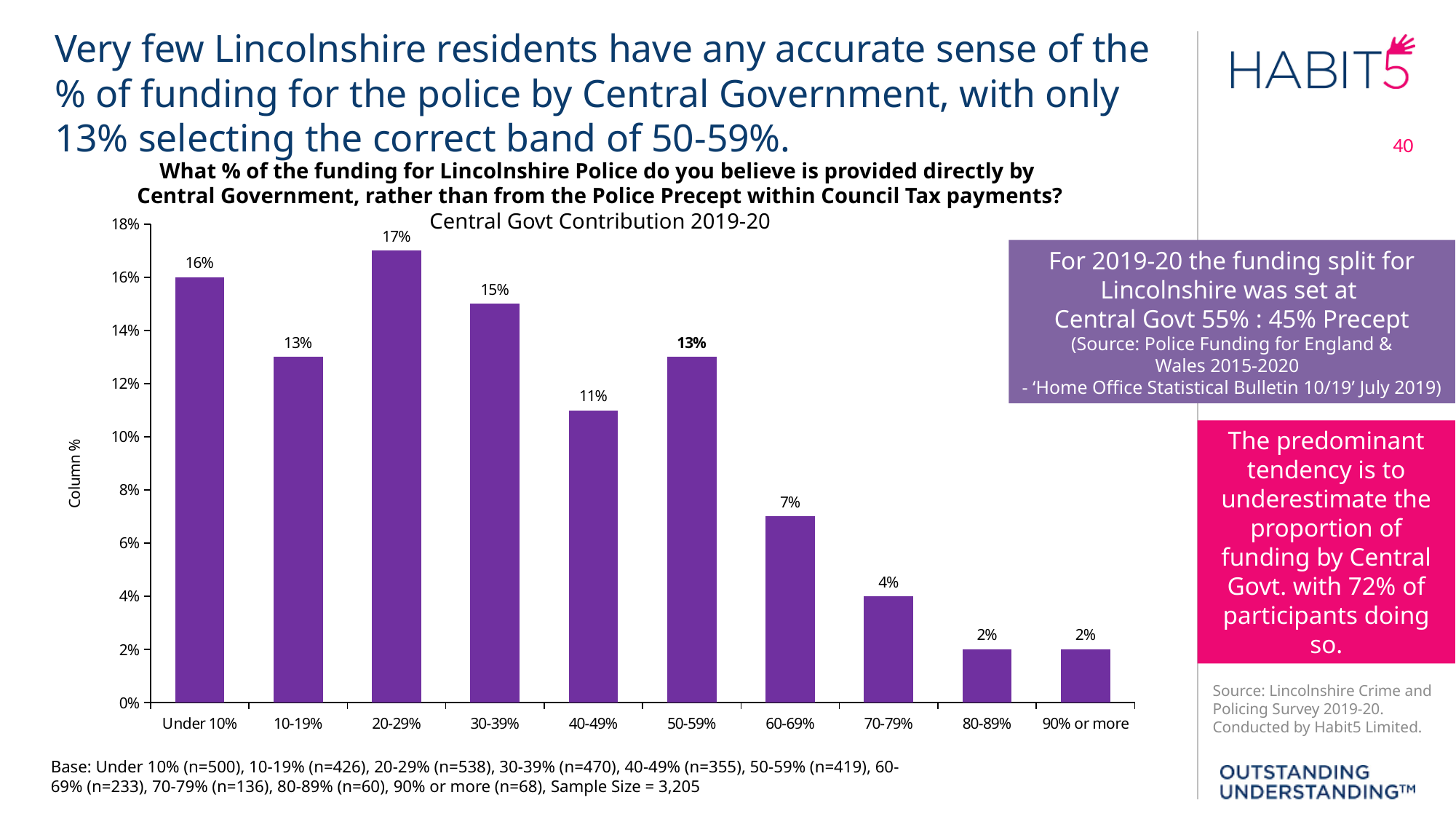
What is the chart's title shown directly above the plot area? Central Govt Contribution 2019-20 How many bands (categories) are shown on the x axis? 10 What is the label of the y axis? Column % What is the difference between the percentage for the 'Under 10%' band and the 10-19% band? 3% Which is larger, the value for 40-49% or the value for 70-79%? 40-49% What is the difference between the percentage for the 30-39% band and the 60-69% band? 8% Do the values generally rise or fall from the 50-59% band to the '90% or more' band? Fall What percentage of respondents selected the 'Under 10%' band? 16% What kind of chart is shown on the slide? Bar chart What percentage of respondents selected the 50-59% band? 13% Which band has the highest percentage of respondents? 20-29% What percentage of respondents selected the 20-29% band? 17%